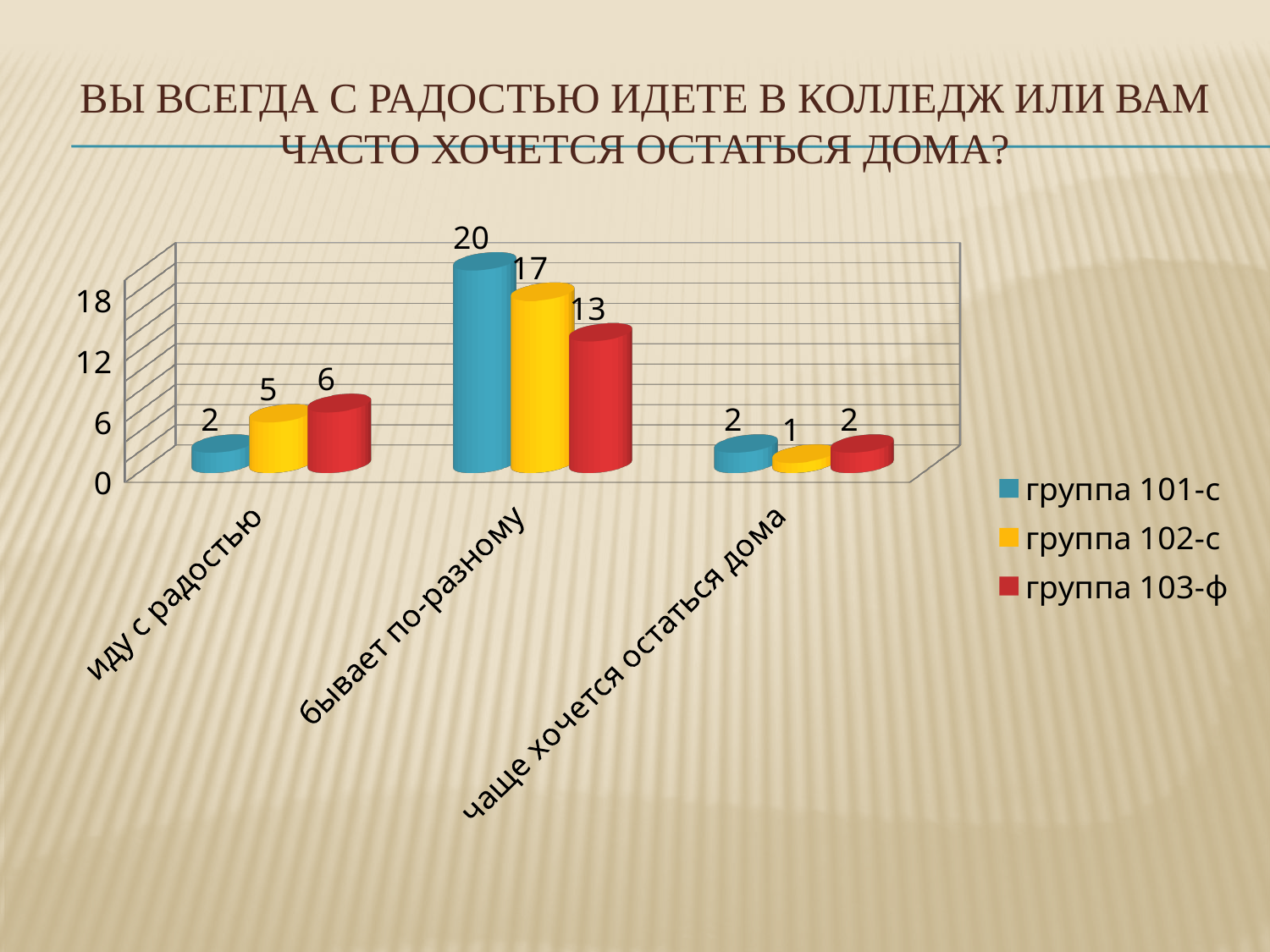
Which category has the highest value for группа 103-ф? бывает по-разному What kind of chart is shown on the slide? bar chart What is the difference between группа 101-с and группа 103-ф in the category 'бывает по-разному'? 7 Which colour represents группа 102-с in the legend? yellow What is the value for группа 102-с in the category 'чаще хочется остаться дома'? 1 How many series does the legend list? 3 What is the value for группа 101-с in the category 'бывает по-разному'? 20 Which is larger in the category 'иду с радостью': группа 102-с or группа 103-ф? группа 103-ф Which series has the lowest value in the category 'иду с радостью'? группа 101-с How many categories are shown on the x axis? 3 What is the value for группа 102-с in the category 'бывает по-разному'? 17 What is the value for группа 103-ф in the category 'иду с радостью'? 6